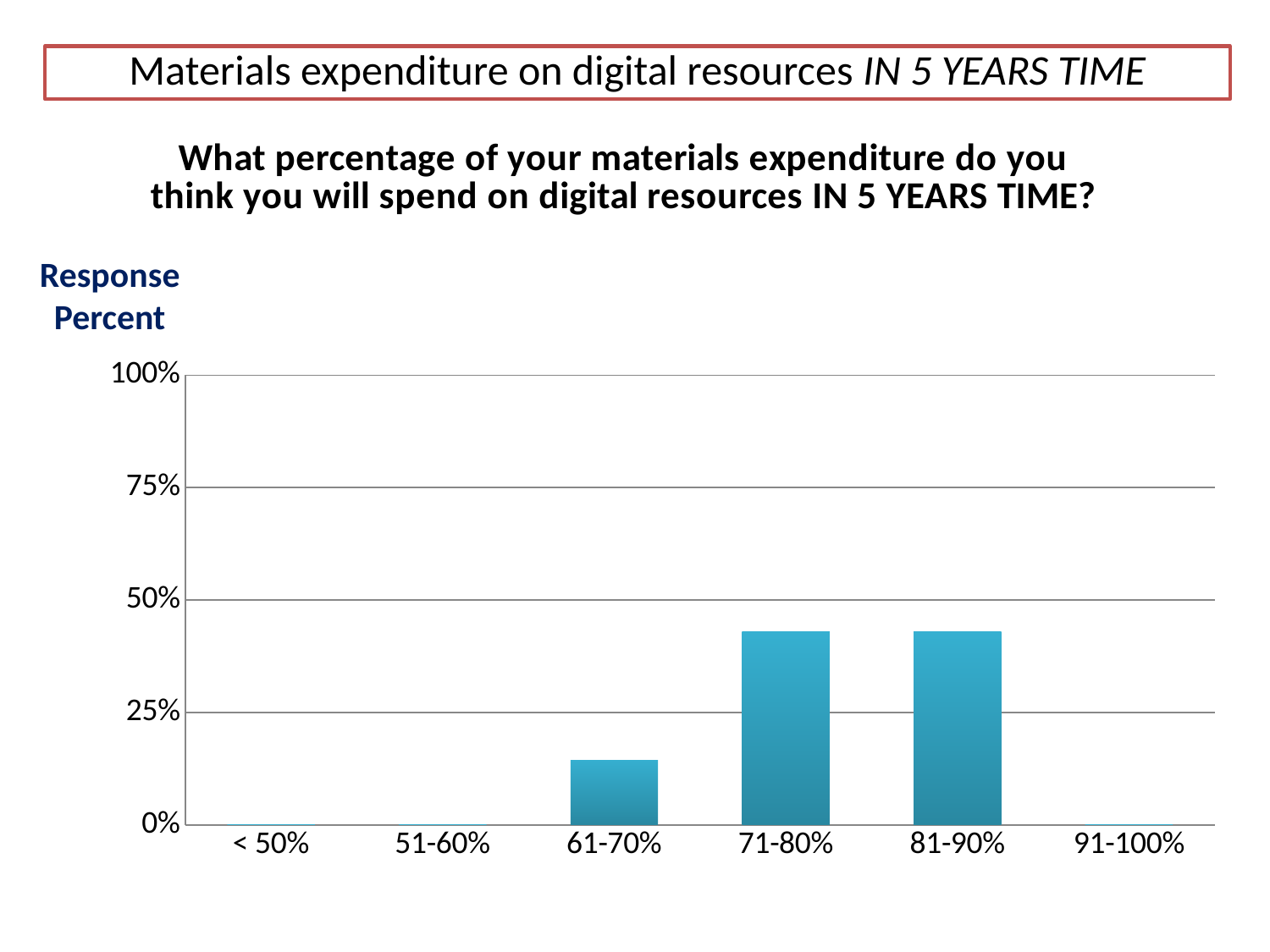
Is the value for 81-90% greater or less than 50%? less How many categories are shown on the x axis of the chart? 6 What is the highest value shown on the vertical axis? 100% Is the value for 61-70% greater or less than 25%? less Is the value for 71-80% greater or less than 50%? less Which is larger, the value for 71-80% or the value for 61-70%? 71-80% What is the value for the < 50% category? 0% What is the label on the vertical axis of the chart? Response Percent What kind of chart is shown on the slide? bar chart Which is larger, the value for 81-90% or the value for 91-100%? 81-90%